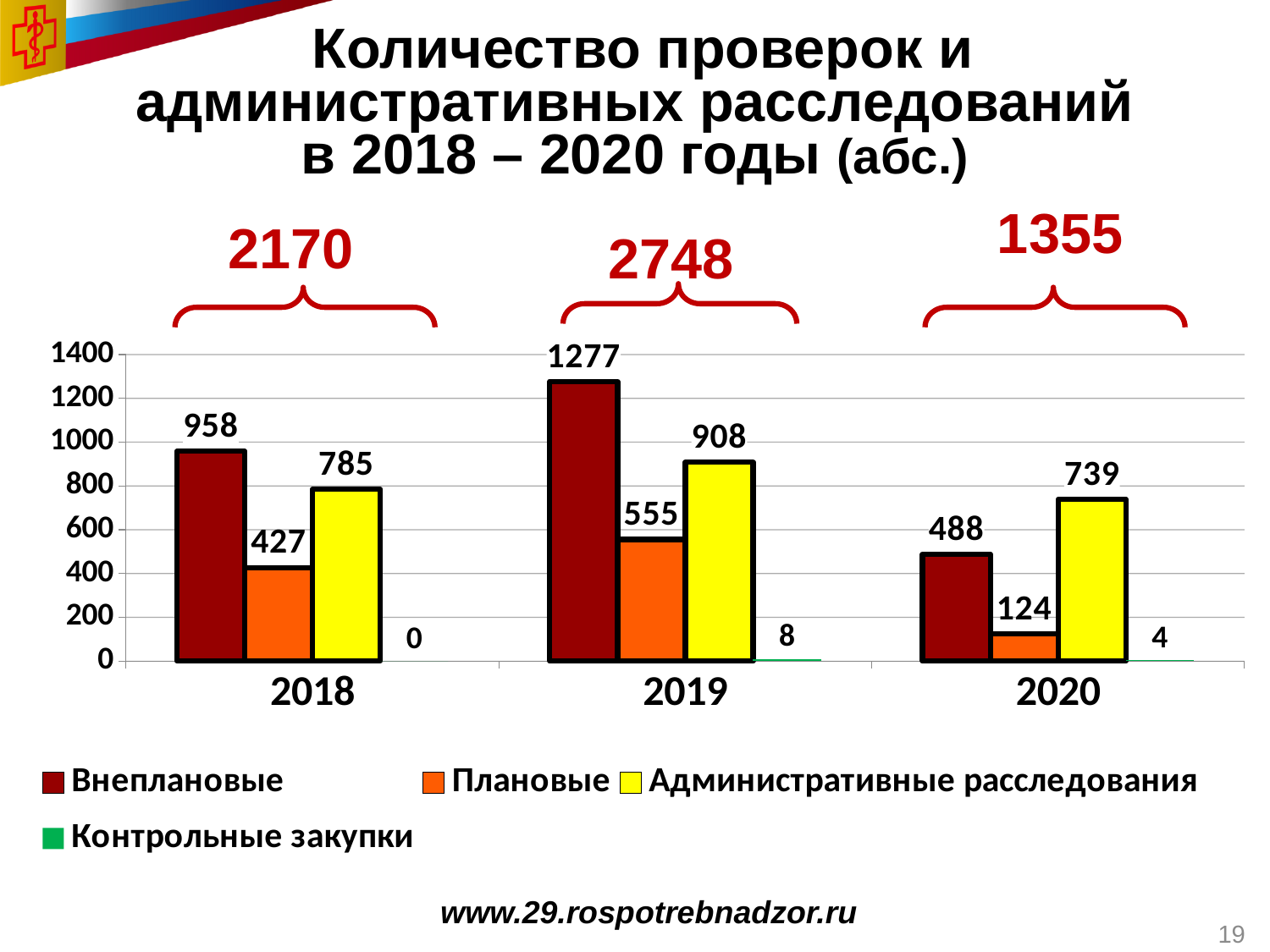
In which year is the value for Плановые the lowest? 2020 What is the value for Контрольные закупки in 2019? 8 How many series does the legend list? 4 Which is larger in 2020: Внеплановые or Административные расследования? Административные расследования What is the value for Внеплановые in 2019? 1277 What kind of chart is shown on the slide? Bar chart How many years are shown on the x axis? 3 In which year is the value for Внеплановые the highest? 2019 What is the value for Административные расследования in 2018? 785 What total is shown above the bars for 2019? 2748 What is the value for Плановые in 2020? 124 What is the difference between the Внеплановые values for 2019 and 2020? 789